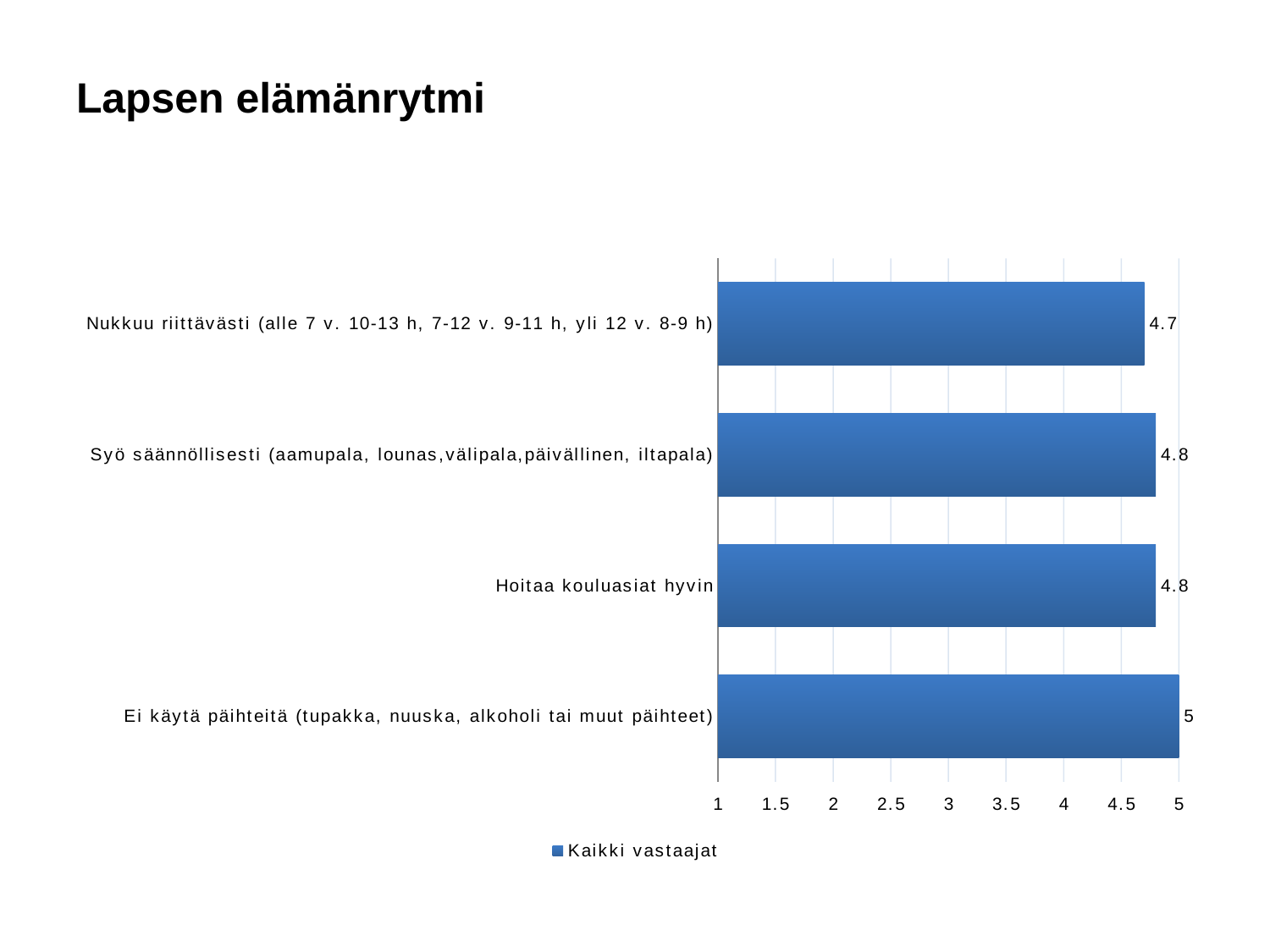
Which category has the highest value? Ei käytä päihteitä (tupakka, nuuska, alkoholi tai muut päihteet) What kind of chart is shown on the slide? bar chart What is the value for "Ei käytä päihteitä (tupakka, nuuska, alkoholi tai muut päihteet)"? 5 How many series does the legend list? 1 What is the value for "Hoitaa kouluasiat hyvin"? 4.8 Which is larger: the value for "Syö säännöllisesti" or the value for "Nukkuu riittävästi"? Syö säännöllisesti Is the value for "Hoitaa kouluasiat hyvin" greater or less than 4? greater What is the value for "Nukkuu riittävästi (alle 7 v. 10-13 h, 7-12 v. 9-11 h, yli 12 v. 8-9 h)"? 4.7 Which category has the lowest value? Nukkuu riittävästi (alle 7 v. 10-13 h, 7-12 v. 9-11 h, yli 12 v. 8-9 h) How many categories are shown in the chart? 4 What is the difference between the value for "Ei käytä päihteitä" and the value for "Nukkuu riittävästi"? 0.3 What is the name of the series shown in the legend? Kaikki vastaajat